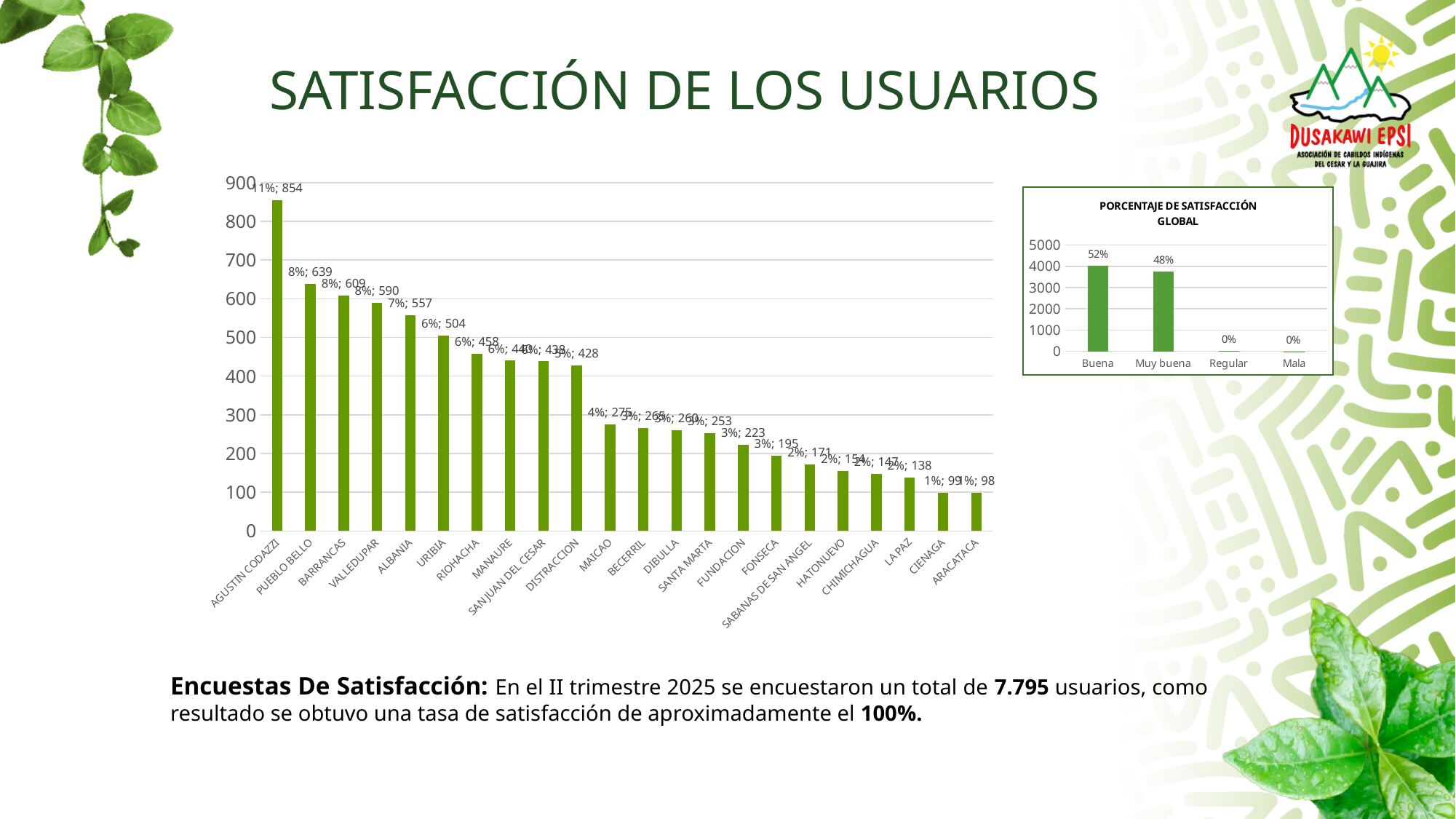
In the large bar chart on the left, which category has the highest value? AGUSTIN CODAZZI In the large bar chart on the left, what is the value for VALLEDUPAR? 590 In the large bar chart on the left, how many categories are shown on the x axis? 22 In the large bar chart on the left, what is the value for FONSECA? 195 In the large bar chart on the left, what is the value for AGUSTIN CODAZZI? 854 In the chart titled PORCENTAJE DE SATISFACCIÓN GLOBAL, what percentage is shown for Buena? 52% What kind of chart is the chart titled PORCENTAJE DE SATISFACCIÓN GLOBAL? bar chart In the large bar chart on the left, which is larger, the value for MAICAO or the value for DIBULLA? MAICAO In the large bar chart on the left, do the values rise or fall from left to right along the x axis? fall In the chart titled PORCENTAJE DE SATISFACCIÓN GLOBAL, is the value for Muy buena greater or less than 4000? less In the large bar chart on the left, what is the difference between the values for PUEBLO BELLO and BARRANCAS? 30 In the chart titled PORCENTAJE DE SATISFACCIÓN GLOBAL, what percentage is shown for Muy buena? 48%